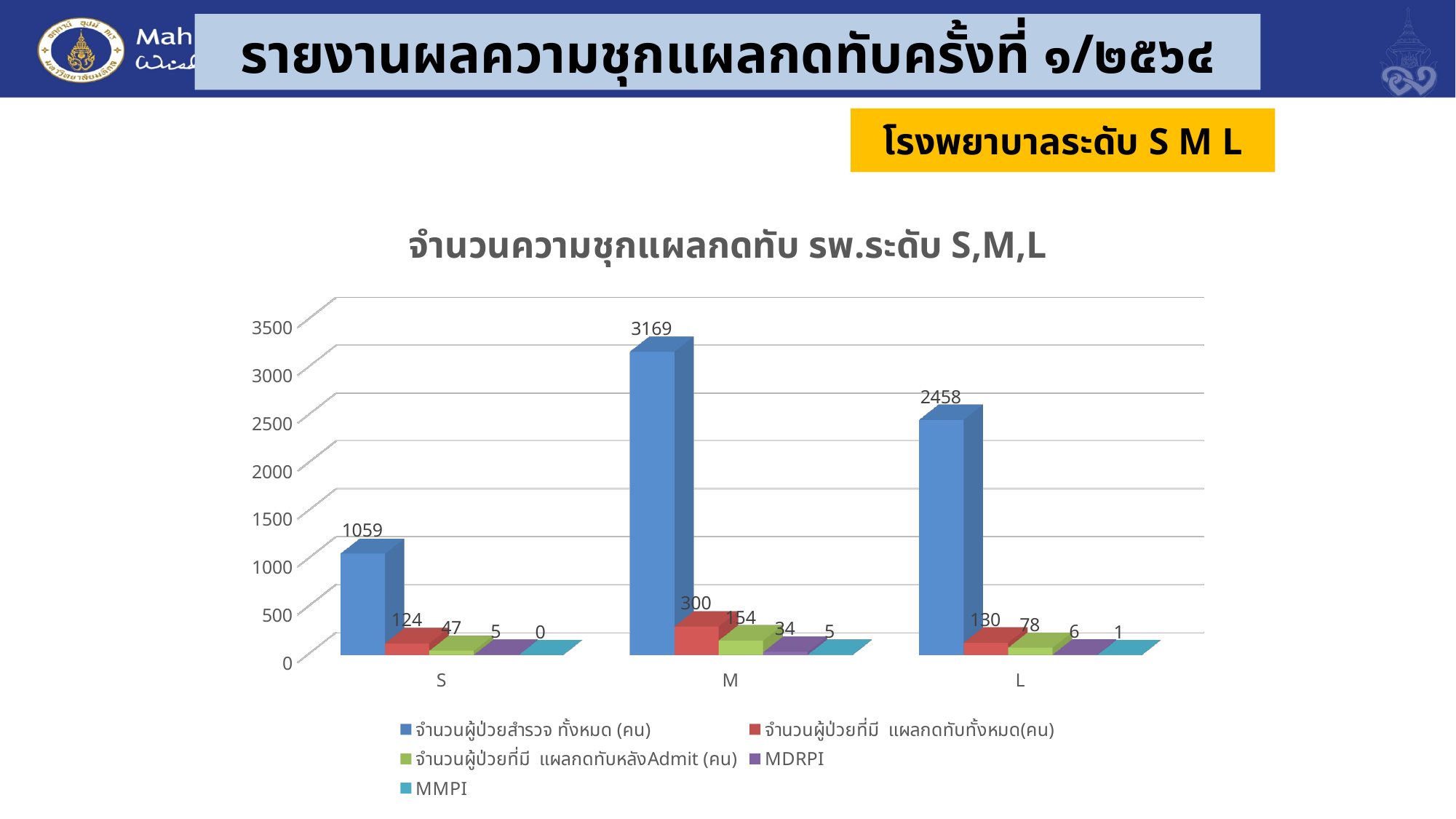
What is the difference between the จำนวนผู้ป่วยสำรวจ ทั้งหมด (คน) values for M and L? 711 How many hospital-level categories are shown on the x axis? 3 What is the MMPI value for hospital level M? 5 What is the value of จำนวนผู้ป่วยสำรวจ ทั้งหมด (คน) for hospital level M? 3169 What type of chart is shown on the slide? bar chart Which is larger: the จำนวนผู้ป่วยที่มี แผลกดทับทั้งหมด(คน) value for S or for L? L What is the title of the chart? จำนวนความชุกแผลกดทับ รพ.ระดับ S,M,L What is the value of จำนวนผู้ป่วยที่มี แผลกดทับทั้งหมด(คน) for hospital level L? 130 What is the MDRPI value for hospital level S? 5 Which hospital level has the lowest value for จำนวนผู้ป่วยที่มี แผลกดทับหลังAdmit (คน)? S Which hospital level has the highest value for จำนวนผู้ป่วยสำรวจ ทั้งหมด (คน)? M How many series does the legend list? 5